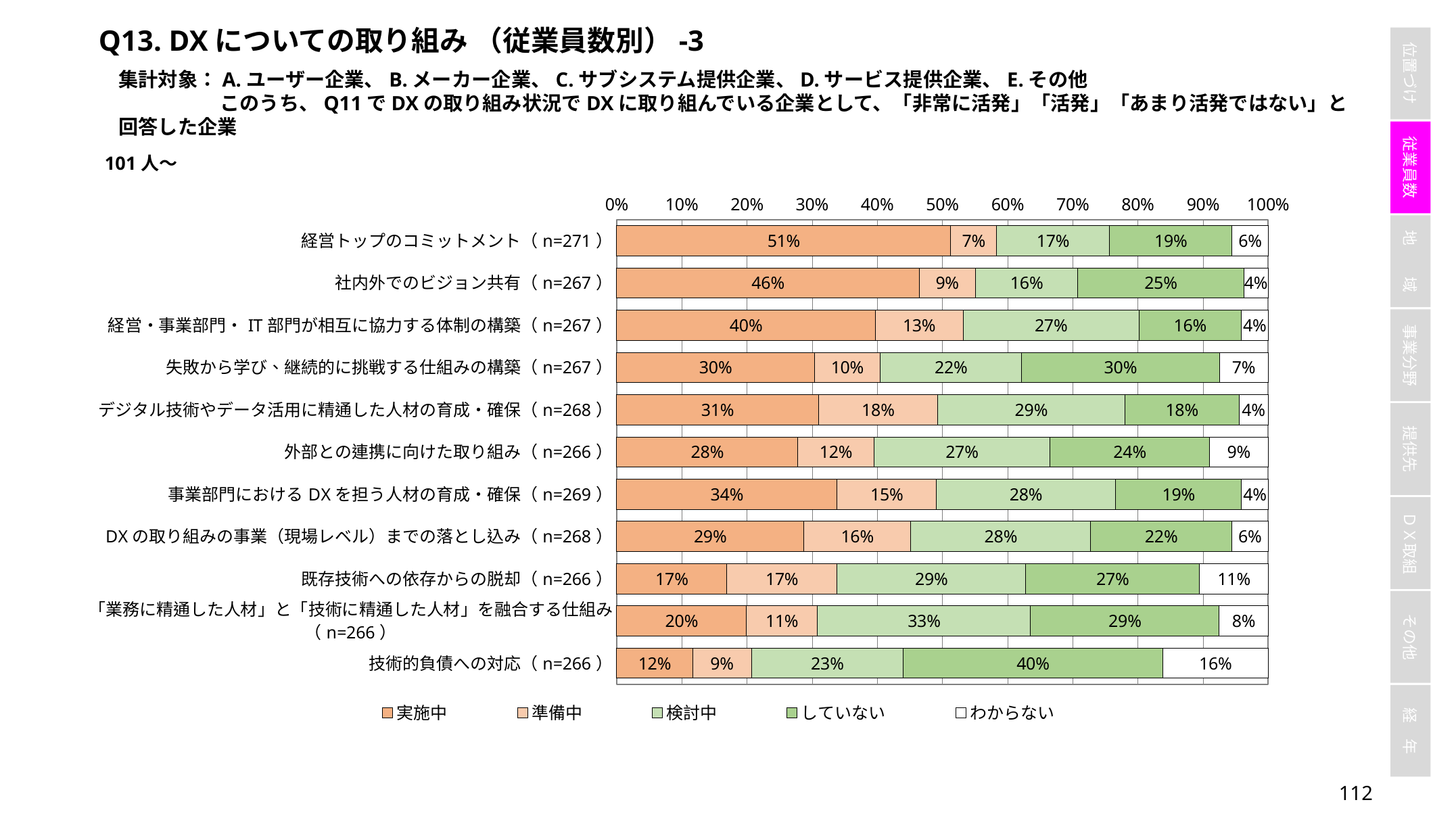
How many categories (items) are plotted in the chart? 11 What is the 検討中 value for 「業務に精通した人材」と「技術に精通した人材」を融合する仕組み? 33% What kind of chart is shown on the slide? Stacked bar chart What is the difference between the 実施中 values for 経営トップのコミットメント and 社内外でのビジョン共有? 5% Which item has the highest 実施中 value? 経営トップのコミットメント Which is larger: the 準備中 value for デジタル技術やデータ活用に精通した人材の育成・確保 or for 外部との連携に向けた取り組み? デジタル技術やデータ活用に精通した人材の育成・確保 How many series does the legend list? 5 What is the 実施中 value for 経営トップのコミットメント? 51% Which item has the lowest 実施中 value? 技術的負債への対応 What is the していない value for 技術的負債への対応? 40% Which item has the highest わからない value? 技術的負債への対応 What is the last entry listed in the legend? わからない